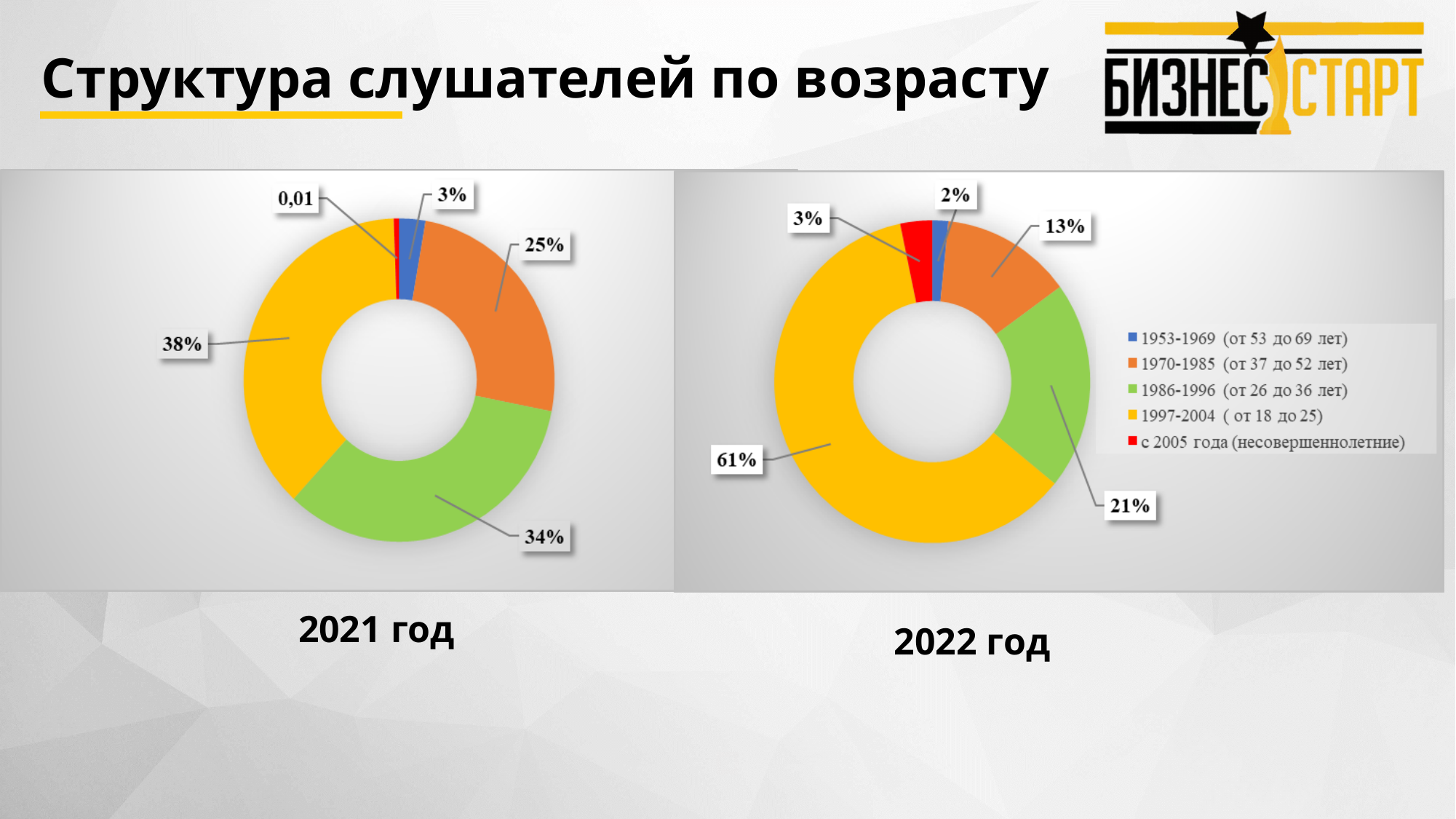
In the 2022 chart, what share is shown for the 1970-1985 (от 37 до 52 лет) group? 13% In the 2022 chart, what share is shown for the 1997-2004 (от 18 до 25) group? 61% In the 2022 chart, which age group has the largest share? 1997-2004 (от 18 до 25) In the 2021 chart, which is larger: the share for 1986-1996 or the share for 1970-1985? 1986-1996 In the 2021 chart, what value is labelled for the 1970-1985 (от 37 до 52 лет) group? 25% How many age groups does the legend list? 5 What kind of chart is used for the 2021 and 2022 data? Doughnut (pie) chart In the 2021 chart, what share is shown for the 1986-1996 (от 26 до 36 лет) group? 34% In the 2021 chart, what share is shown for the 1997-2004 (от 18 до 25) group? 38% In the 2022 chart, what share is shown for the с 2005 года (несовершеннолетние) group? 3% In the 2022 chart, what is the difference between the share for 1997-2004 and the share for 1986-1996? 40% In the 2022 chart, which age group has the smallest share? 1953-1969 (от 53 до 69 лет)